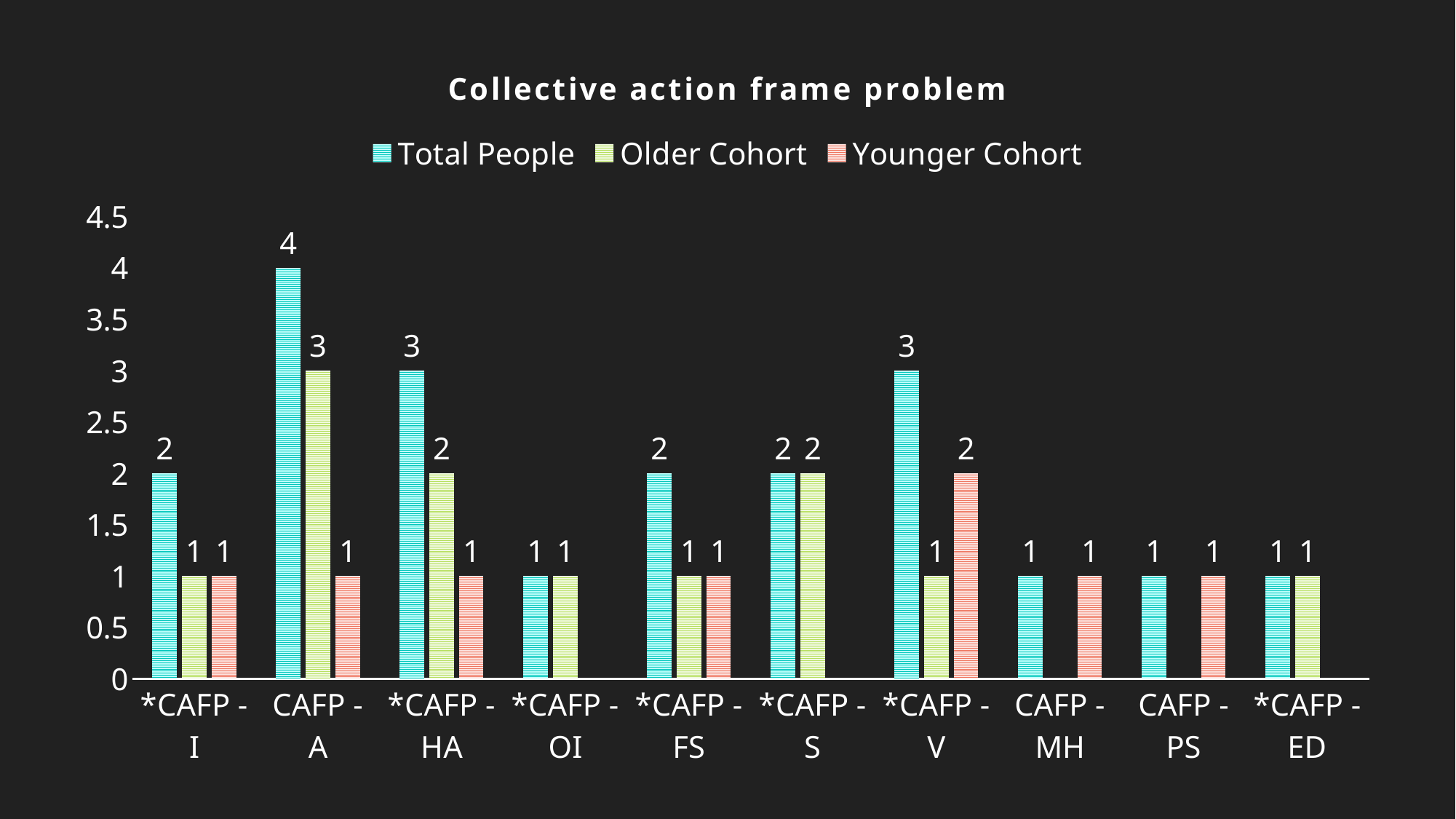
What is the difference between the Total People values for CAFP - A and *CAFP - I? 2 What is the Younger Cohort value for *CAFP - V? 2 What is the Total People value for CAFP - A? 4 What is the title of the chart? Collective action frame problem How many categories are shown on the x axis? 10 Which is larger for *CAFP - V: the Older Cohort value or the Younger Cohort value? Younger Cohort What is the Older Cohort value for *CAFP - HA? 2 What is the Total People value for *CAFP - S? 2 Which category has the highest Older Cohort value? CAFP - A What kind of chart is this? Bar chart Which category has the highest Total People value? CAFP - A How many series does the legend list? 3